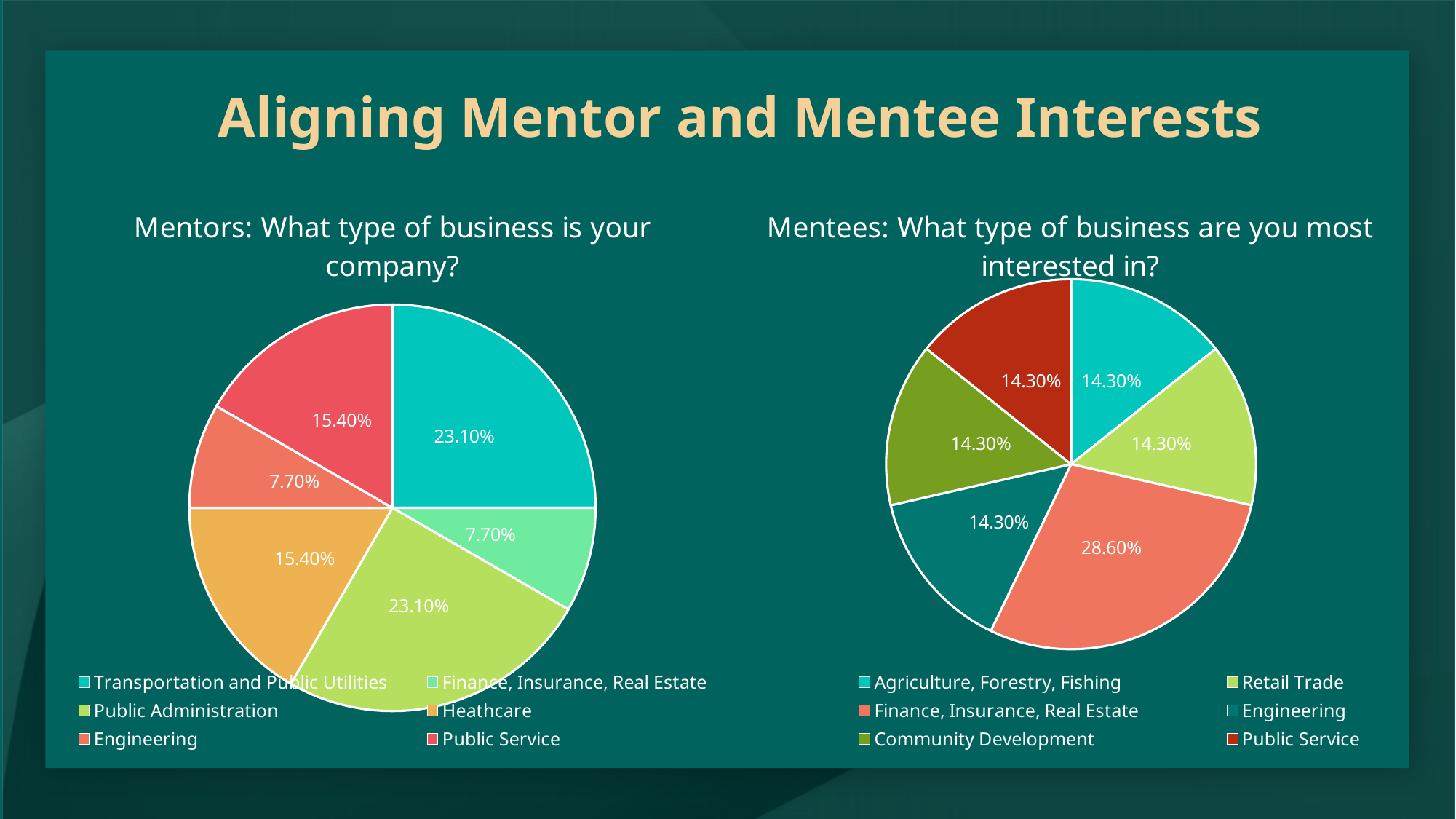
In the Mentors chart, what is the difference in percentage points between Public Administration and Public Service? 7.70 In the Mentees chart, which business type has the largest slice? Finance, Insurance, Real Estate What is the title of the chart on the left of the slide? Mentors: What type of business is your company? In the Mentors chart, which is larger: Healthcare or Finance, Insurance, Real Estate? Healthcare How many slices does the Mentors chart have? 6 In the Mentors chart, what percentage is shown for Transportation and Public Utilities? 23.10% In the Mentors chart, what percentage is shown for Healthcare? 15.40% In the Mentees chart, what percentage is shown for Community Development? 14.30% In the Mentors chart, what percentage is shown for Engineering? 7.70% In the Mentees chart, what is the difference in percentage points between Finance, Insurance, Real Estate and Retail Trade? 14.30 What kind of chart is the Mentees chart? Pie chart In the Mentees chart, what percentage is shown for Finance, Insurance, Real Estate? 28.60%